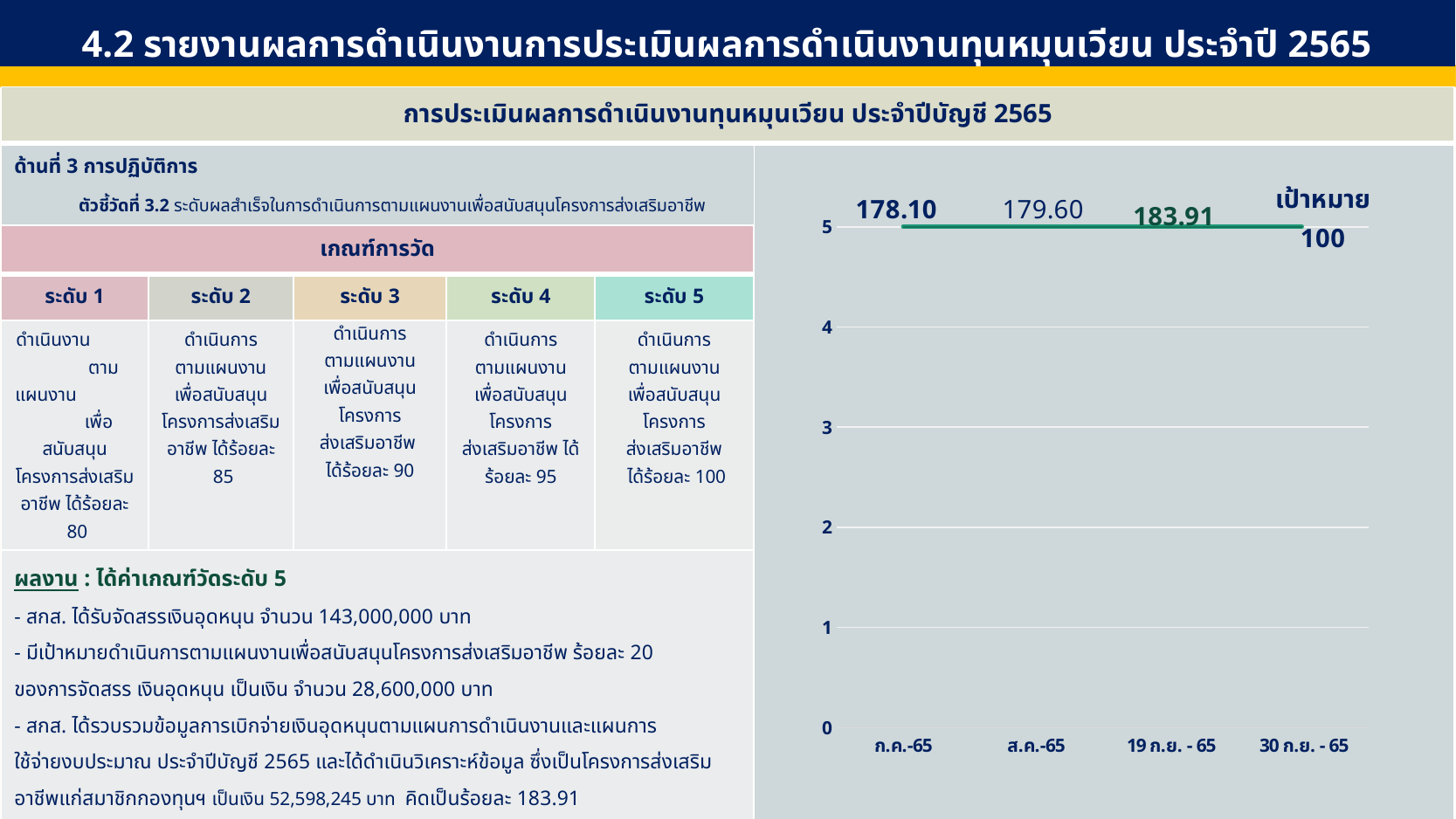
Is the plotted level of the line at ก.ค.-65 greater or less than 4 on the y axis? greater Which labelled point on the chart has the lowest data label value? ก.ค.-65 What is the highest tick value shown on the y axis of the chart? 5 What is the difference between the data labels for 19 ก.ย. - 65 and ก.ค.-65? 5.81 How many categories are shown on the x axis of the chart? 4 Which labelled point on the chart has the highest data label value? 19 ก.ย. - 65 What data label is printed above the ก.ค.-65 point on the chart? 178.10 What target value (เป้าหมาย) is printed on the chart? 100 What data label is printed above the 19 ก.ย. - 65 point on the chart? 183.91 What data label is printed above the ส.ค.-65 point on the chart? 179.60 What kind of chart is shown on the right side of the slide? line chart Which is larger, the data label for ส.ค.-65 or for ก.ค.-65? ส.ค.-65